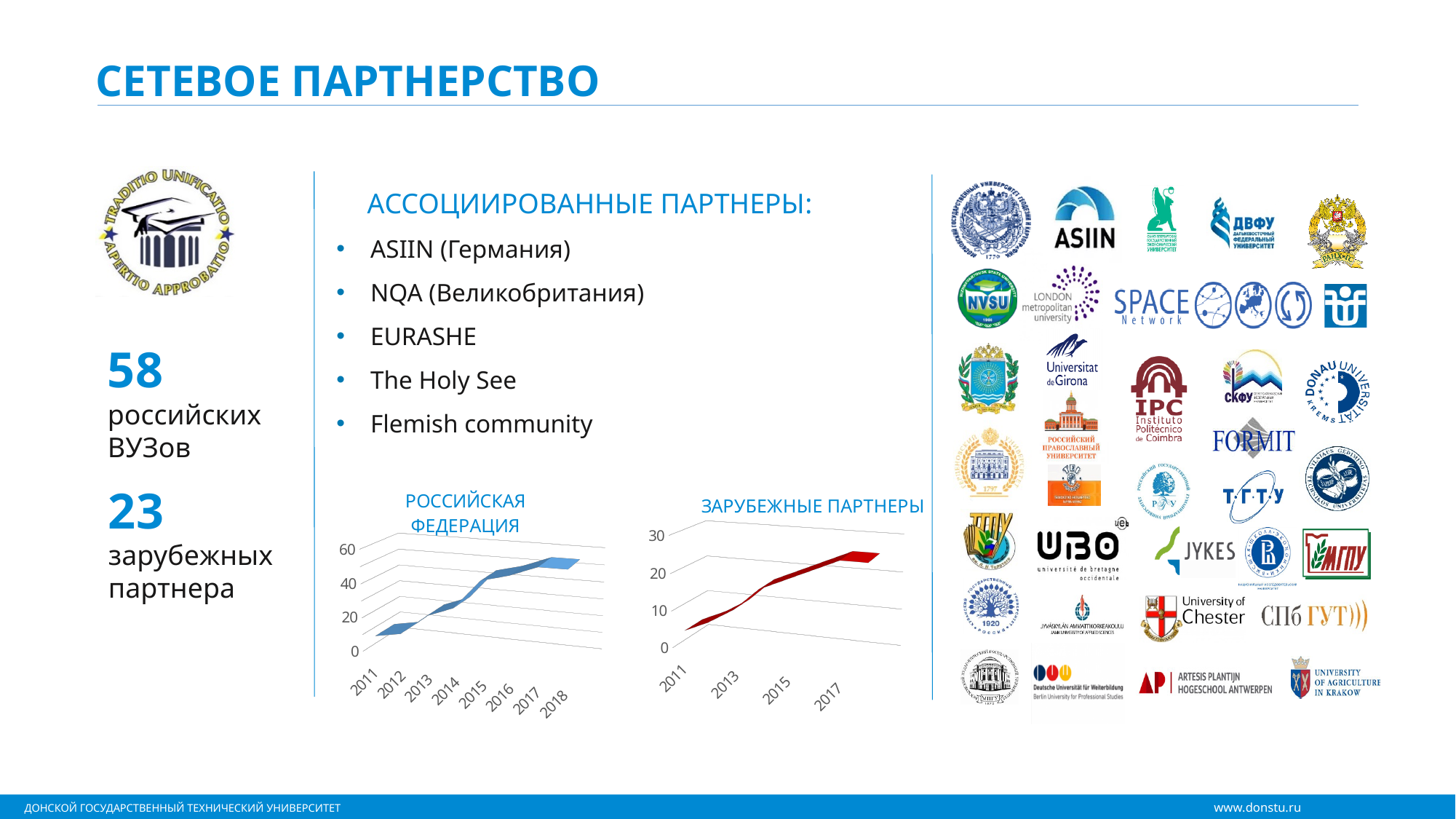
In the 'ЗАРУБЕЖНЫЕ ПАРТНЕРЫ' chart, is the value for 2017 greater or less than 20? greater In the 'РОССИЙСКАЯ ФЕДЕРАЦИЯ' chart, do the values rise or fall from 2011 to 2018? rise In the 'ЗАРУБЕЖНЫЕ ПАРТНЕРЫ' chart, do the values rise or fall from 2011 to 2017? rise In the 'РОССИЙСКАЯ ФЕДЕРАЦИЯ' chart, which year has the higher value, 2011 or 2018? 2018 In the 'ЗАРУБЕЖНЫЕ ПАРТНЕРЫ' chart, which year has the lowest value? 2011 What kind of chart is the 'РОССИЙСКАЯ ФЕДЕРАЦИЯ' chart? line chart In the 'РОССИЙСКАЯ ФЕДЕРАЦИЯ' chart, is the value for 2018 greater or less than 40? greater In the 'РОССИЙСКАЯ ФЕДЕРАЦИЯ' chart, is the value for 2011 greater or less than 20? less What colour is the area in the 'ЗАРУБЕЖНЫЕ ПАРТНЕРЫ' chart? red How many year labels are shown on the x axis of the 'РОССИЙСКАЯ ФЕДЕРАЦИЯ' chart? 8 How many year labels are shown on the x axis of the 'ЗАРУБЕЖНЫЕ ПАРТНЕРЫ' chart? 4